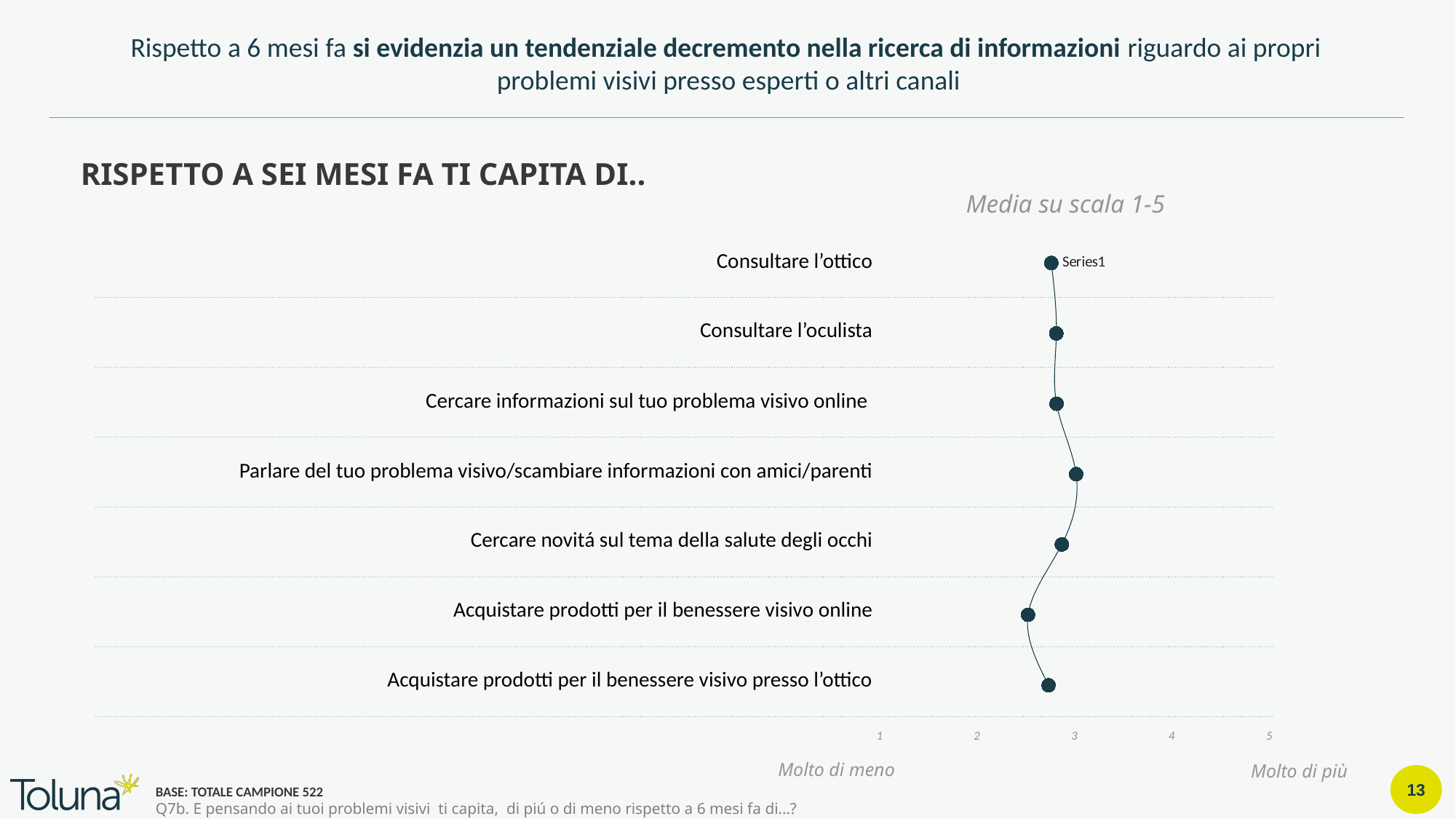
Which category has the highest value on the chart? Parlare del tuo problema visivo/scambiare informazioni con amici/parenti Which has the larger value: 'Parlare del tuo problema visivo/scambiare informazioni con amici/parenti' or 'Acquistare prodotti per il benessere visivo online'? Parlare del tuo problema visivo/scambiare informazioni con amici/parenti Which category has the lowest value on the chart? Acquistare prodotti per il benessere visivo online Is the value for 'Acquistare prodotti per il benessere visivo online' greater or less than 3? less What kind of chart is shown on the slide? line chart How many categories are plotted on the chart? 7 What scale does the chart subtitle say the averages are measured on? Media su scala 1-5 Is the value for 'Acquistare prodotti per il benessere visivo presso l'ottico' greater or less than 2? greater Is the value for 'Consultare l'ottico' greater or less than 3? less Which has the larger value: 'Cercare novitá sul tema della salute degli occhi' or 'Acquistare prodotti per il benessere visivo online'? Cercare novitá sul tema della salute degli occhi